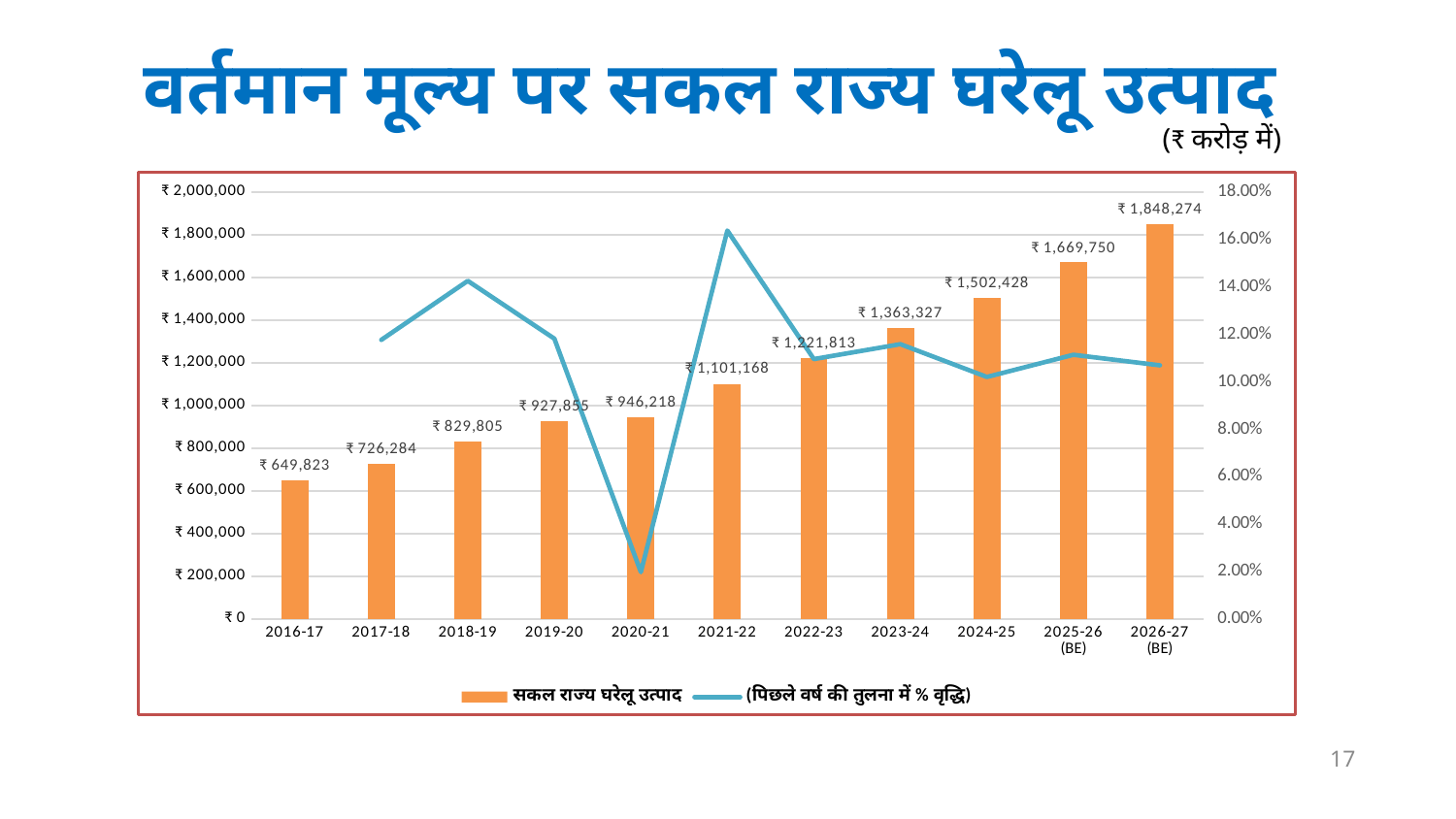
What is the difference in सकल राज्य घरेलू उत्पाद between 2026-27 (BE) and 2025-26 (BE)? ₹ 178,524 In which year does the % वृद्धि line reach its highest point? 2021-22 What is the value of सकल राज्य घरेलू उत्पाद for 2016-17? ₹ 649,823 What is the value of सकल राज्य घरेलू उत्पाद for 2026-27 (BE)? ₹ 1,848,274 How many years are shown on the x axis? 11 Which year has the highest सकल राज्य घरेलू उत्पाद? 2026-27 (BE) Which year has the lowest सकल राज्य घरेलू उत्पाद? 2016-17 Which is larger, the सकल राज्य घरेलू उत्पाद for 2019-20 or for 2020-21? 2020-21 How many series does the legend list? 2 What is the value of सकल राज्य घरेलू उत्पाद for 2023-24? ₹ 1,363,327 Is the % वृद्धि (growth) value for 2020-21 greater or less than 4.00%? less Is the % वृद्धि (growth) value for 2021-22 greater or less than 14.00%? greater